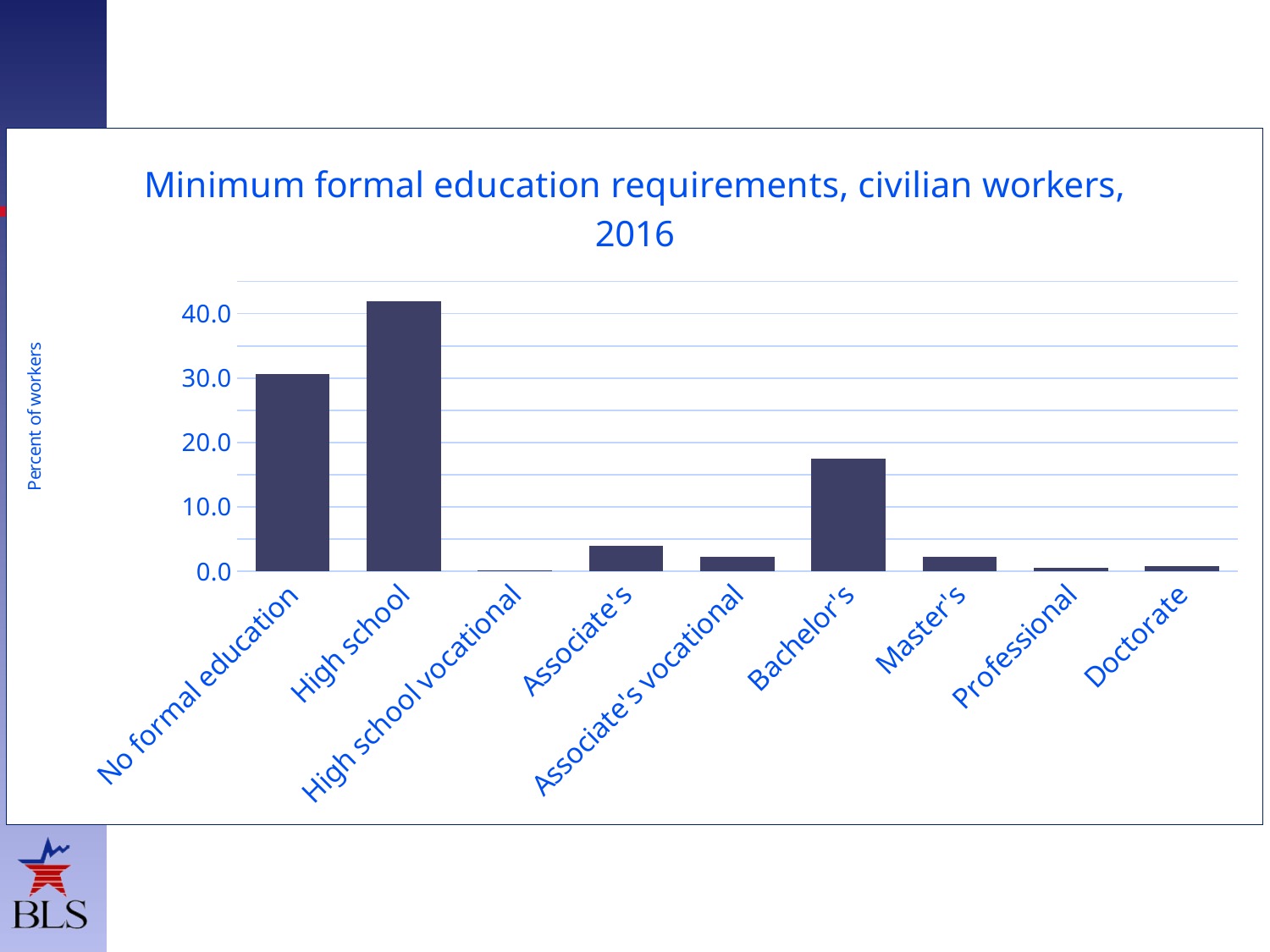
Is the value for Bachelor's greater or less than 10.0? greater Is the value for High school greater or less than 40.0? greater Which is larger, the value for No formal education or the value for Bachelor's? No formal education Is the value for No formal education greater or less than 40.0? less What type of chart is shown on the slide? Bar chart What is the label on the vertical axis of the chart? Percent of workers How many education categories are shown on the x axis? 9 Which is larger, the value for Associate's or the value for Associate's vocational? Associate's Which education category has the highest percent of workers? High school Which education category has the lowest percent of workers? High school vocational